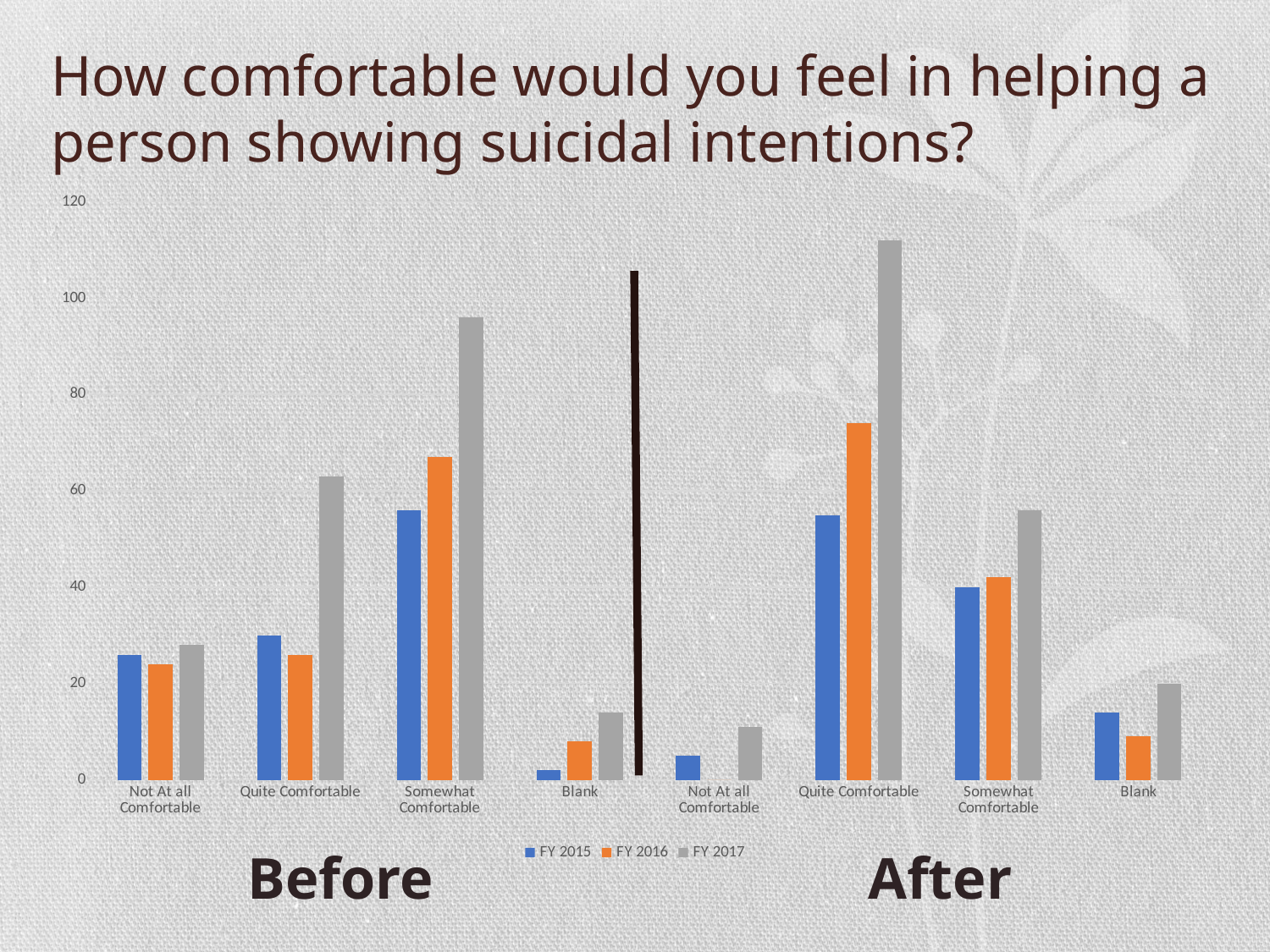
In the Before section for Somewhat Comfortable, which is larger: FY 2015 or FY 2016? FY 2016 How many series does the legend list? 3 In the Before section for Blank, which series has the lowest value? FY 2015 In the After section, is the FY 2017 value for Quite Comfortable greater or less than 100? greater In the After section for Quite Comfortable, which is larger: FY 2015 or FY 2016? FY 2016 In the Before section, is the FY 2015 value for Quite Comfortable greater or less than 40? less What kind of chart is shown on the slide? bar chart Which series does the legend list? FY 2015, FY 2016, FY 2017 How many categories are shown along the x axis of the chart (counting both the Before and After sections)? 8 What colour are the FY 2016 bars? orange Which bar is the tallest in the whole chart? FY 2017 for Quite Comfortable in the After section In the Before section, is the FY 2017 value for Somewhat Comfortable greater or less than 80? greater